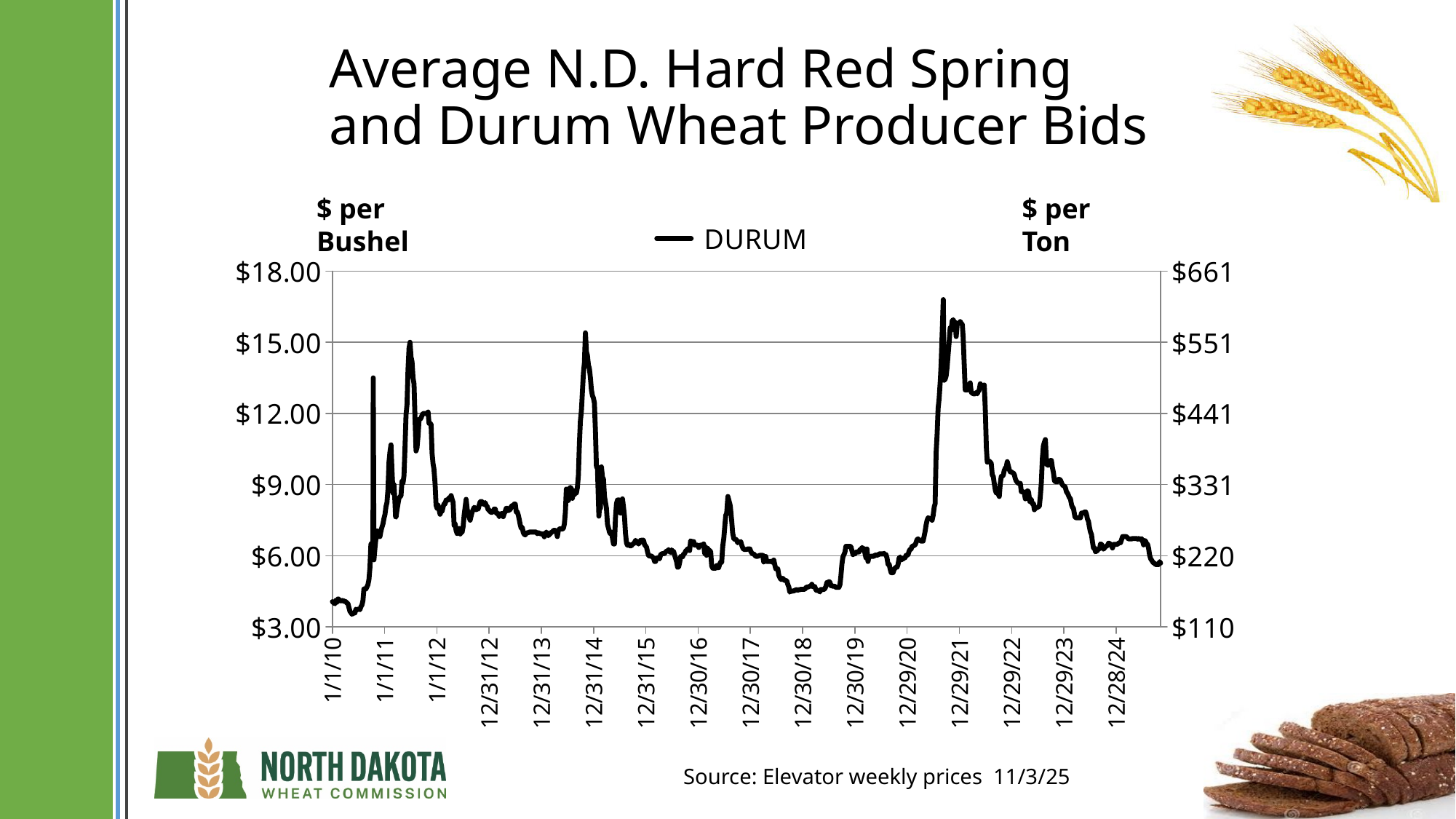
Is the DURUM value at 1/1/10 greater or less than $6.00 per bushel? less What series name appears in the chart legend? DURUM Does the DURUM line rise or fall between 12/29/21 and 12/28/24? fall What kind of chart is shown on the slide? line chart Is the DURUM value at 12/29/21 greater or less than $12.00 per bushel? greater Is the DURUM value at 12/30/18 greater or less than $6.00 per bushel? less What is the unit label on the left vertical axis of the chart? $ per Bushel Is the DURUM peak near 12/29/21 higher or lower than the peak near 12/31/14? higher How many series does the legend list? 1 Does the DURUM line rise or fall between 12/30/18 and 12/29/21? rise